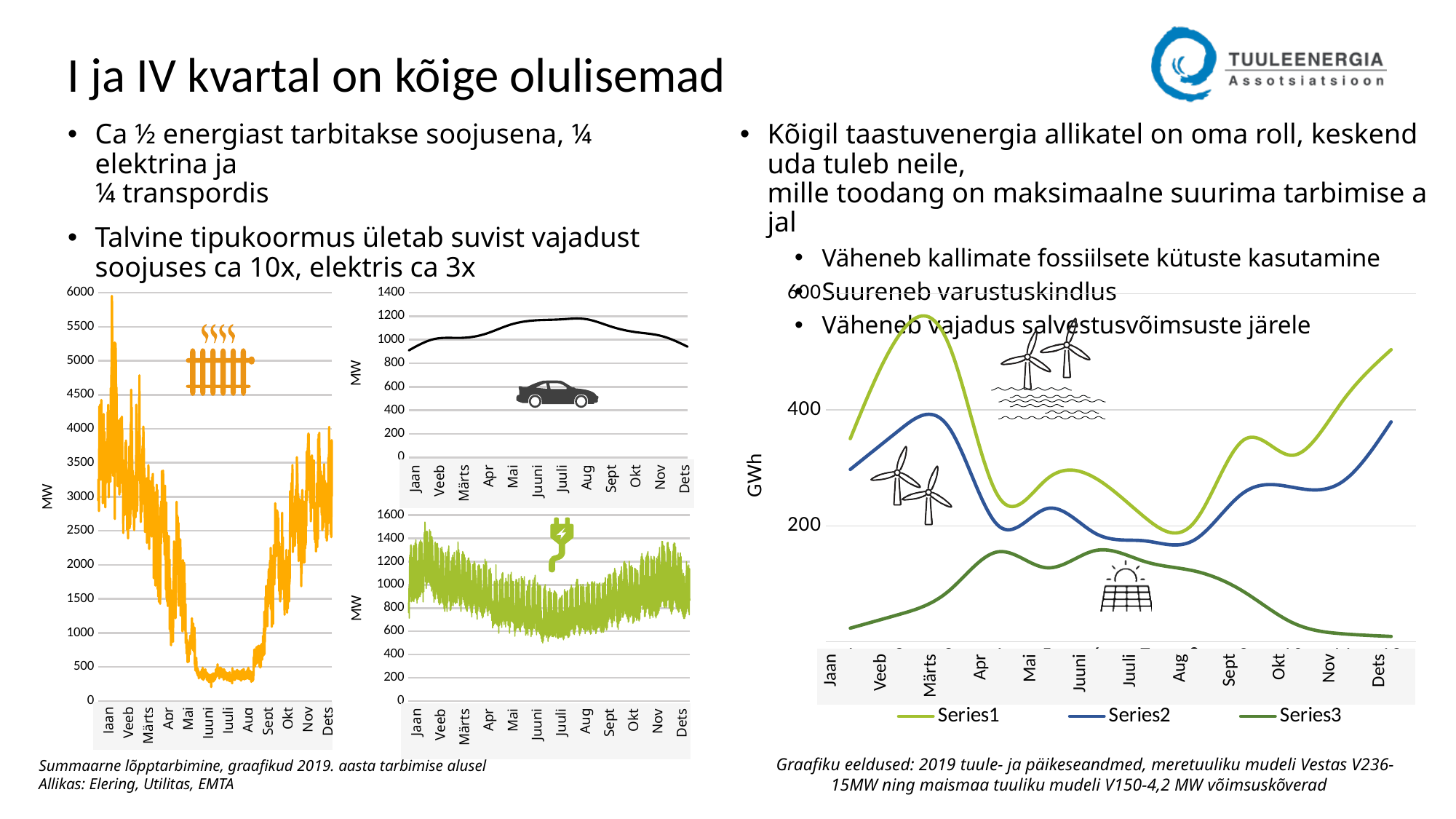
On the right-hand chart (GWh), how many series does the legend list? 3 What kind of chart is the orange chart on the left of the slide? line chart On the right-hand chart (GWh), what are the legend entries? Series1, Series2, Series3 On the right-hand chart (GWh), is the value of Series1 in Märts greater or less than 400? greater On the orange chart on the left (MW), is the value in Juuli greater or less than 1000? less On the top-middle chart with the car icon (MW), do the values rise or fall from Jaan to Aug? rise On the right-hand chart (GWh), is the value of Series3 in Aug greater or less than 200? less On the right-hand chart (GWh), how many months are shown on the x axis? 12 On the right-hand chart (GWh), which is larger in Jaan: Series2 or Series3? Series2 On the right-hand chart (GWh), which series has the highest value in Märts? Series1